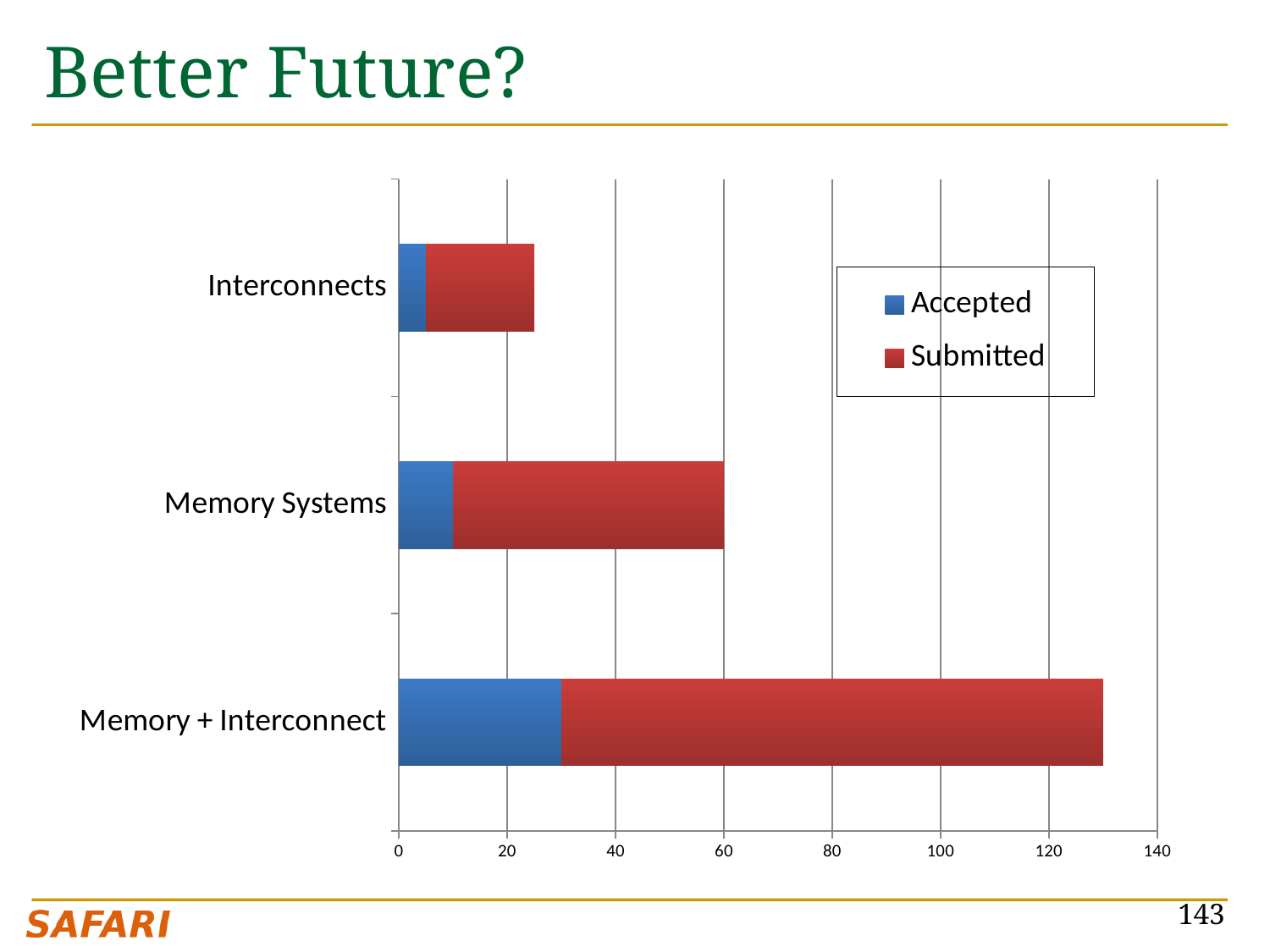
Is the total length of the Memory + Interconnect bar greater or less than 120? greater Which bar is longer overall, Memory Systems or Interconnects? Memory Systems Is the Accepted value for Memory Systems greater or less than 20? less Is the Accepted value for Memory + Interconnect greater or less than 20? greater What value on the x axis does the Memory Systems bar reach? 60 Which category has the shortest bar overall? Interconnects How many categories are plotted on the chart? 3 What are the two series named in the legend? Accepted and Submitted How many series does the legend list? 2 What kind of chart is shown on the slide? bar chart Which category has the longest bar overall? Memory + Interconnect